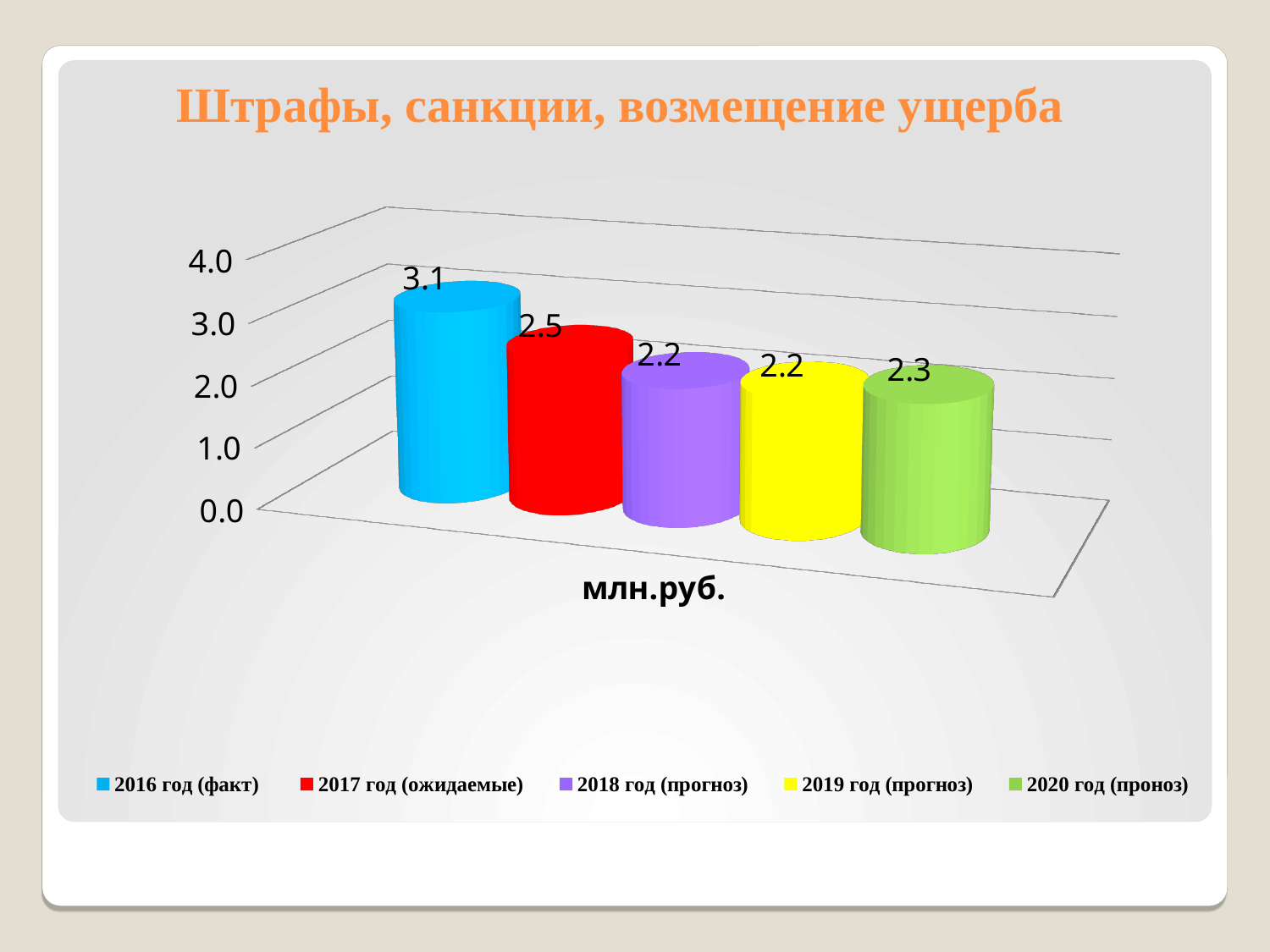
What is the value for 2016 год (факт)? 3.1 What is the value for 2020 год (проноз)? 2.3 Is the value for 2016 год (факт) greater or less than 3.0? greater What is the difference between the values for 2017 год (ожидаемые) and 2020 год (проноз)? 0.2 What is the title of the chart? Штрафы, санкции, возмещение ущерба Which is larger, the value for 2016 год (факт) or the value for 2020 год (проноз)? 2016 год (факт) What kind of chart is shown on the slide? bar chart What is the value for 2017 год (ожидаемые)? 2.5 What unit label is shown below the bars? млн.руб. Which series has the highest value? 2016 год (факт) How many series does the legend list? 5 What is the difference between the values for 2016 год (факт) and 2017 год (ожидаемые)? 0.6